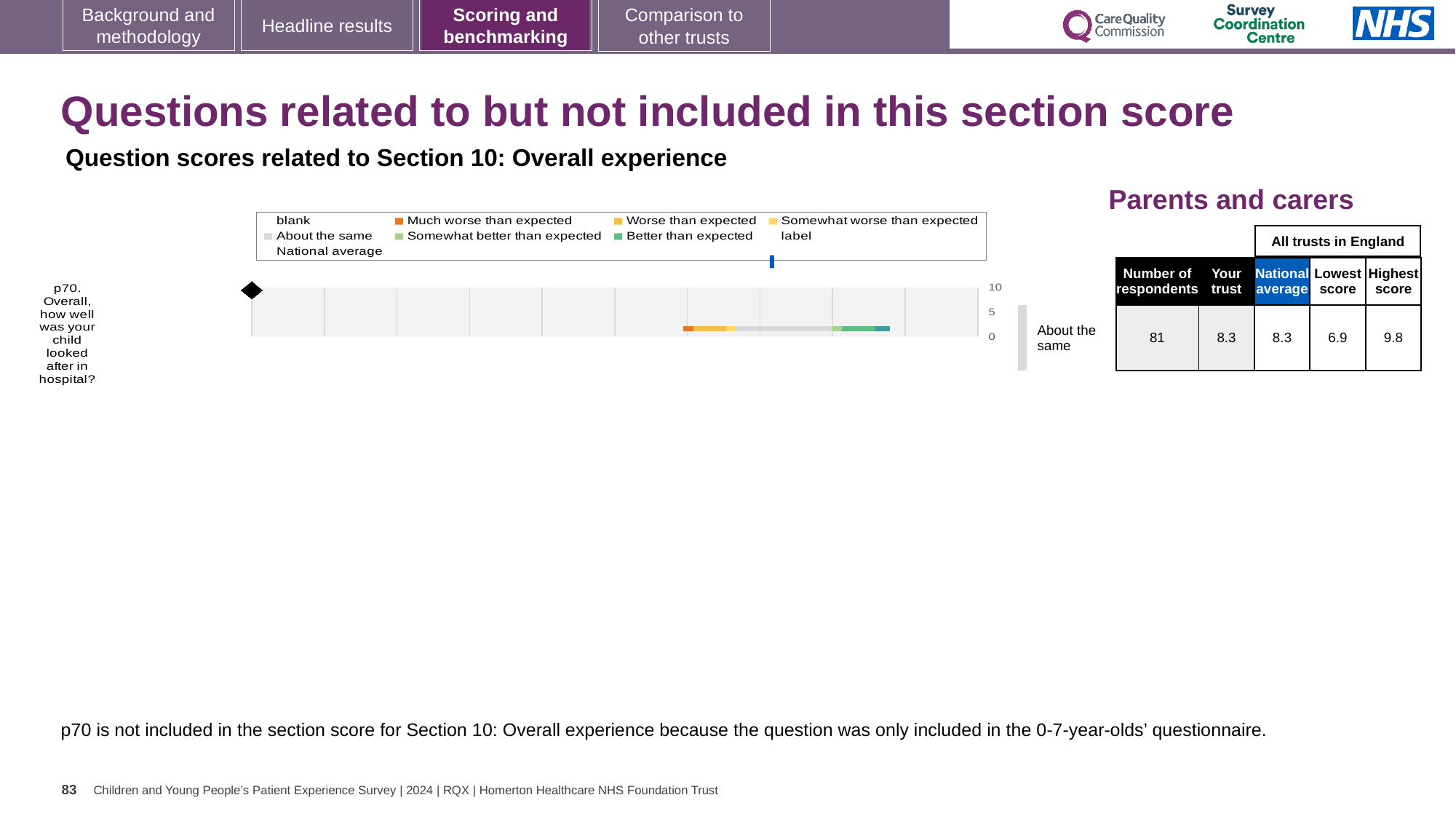
What is the highest score among all trusts in England for p70? 9.8 Is the 'Your trust' score for p70 greater or less than 5? greater Which question is plotted in the chart? p70. Overall, how well was your child looked after in hospital? How many survey questions are plotted in the chart? 1 What is the national average score for p70? 8.3 How many respondents answered p70? 81 What kind of chart is shown on the slide? bar chart What is the difference between the highest and lowest trust scores for p70? 2.9 What is the lowest score among all trusts in England for p70? 6.9 What is the 'Your trust' score for p70? 8.3 What is the highest tick value shown on the chart's axis? 10 What is the benchmark category shown next to the chart for p70? About the same